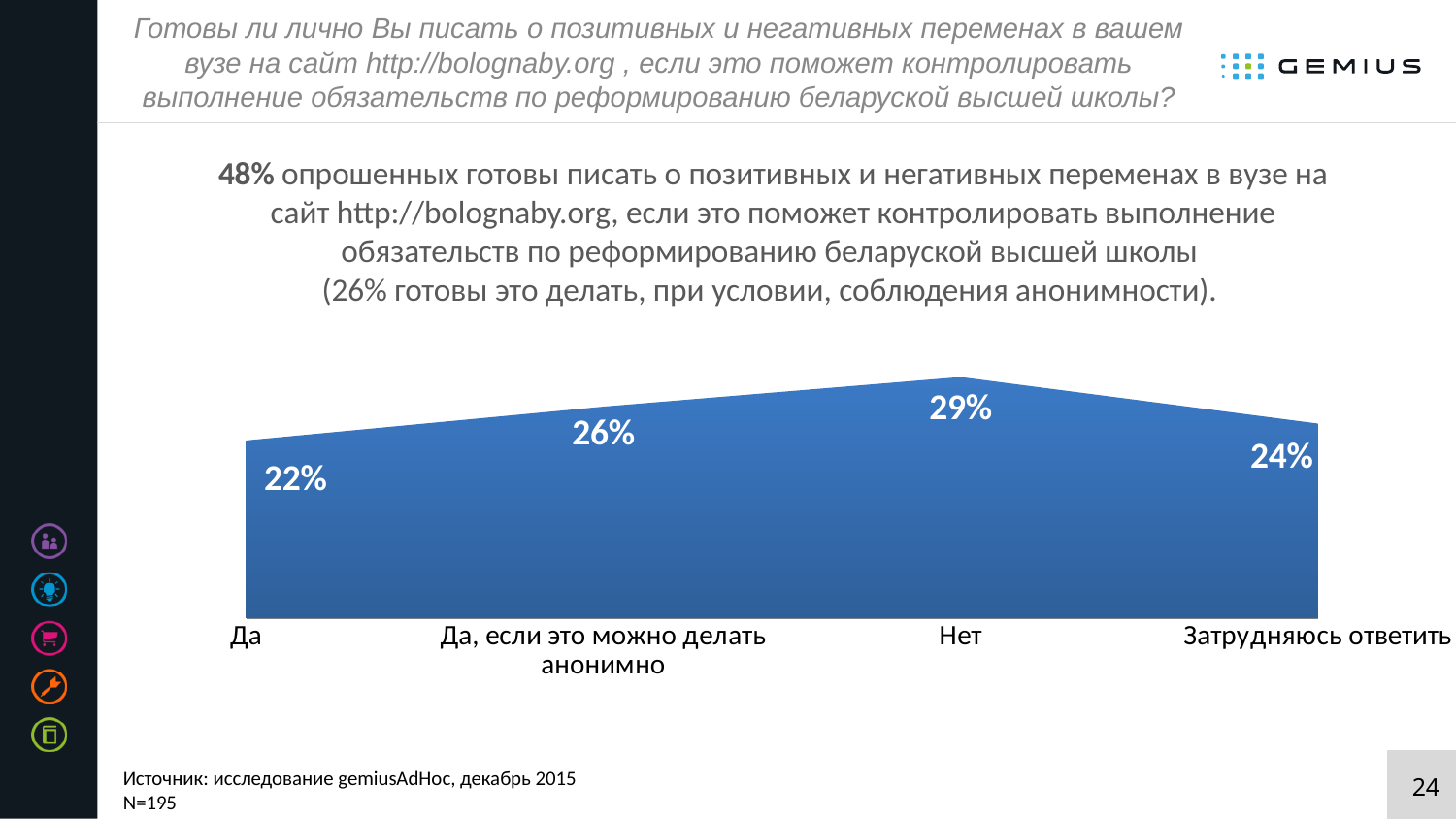
Which category has the lowest value? Да What kind of chart is shown on the slide? Area chart How many categories are plotted on the chart? 4 What value is shown for the category "Да"? 22% What value is shown for "Да, если это можно делать анонимно"? 26% What is the difference between the values for "Нет" and "Да"? 7% What is the difference between the values for "Да, если это можно делать анонимно" and "Затрудняюсь ответить"? 2% What is the combined value of "Да" and "Да, если это можно делать анонимно"? 48% Which category has the highest value? Нет What value is shown for the category "Нет"? 29% Which is larger: the value for "Да" or the value for "Затрудняюсь ответить"? Затрудняюсь ответить What value is shown for "Затрудняюсь ответить"? 24%